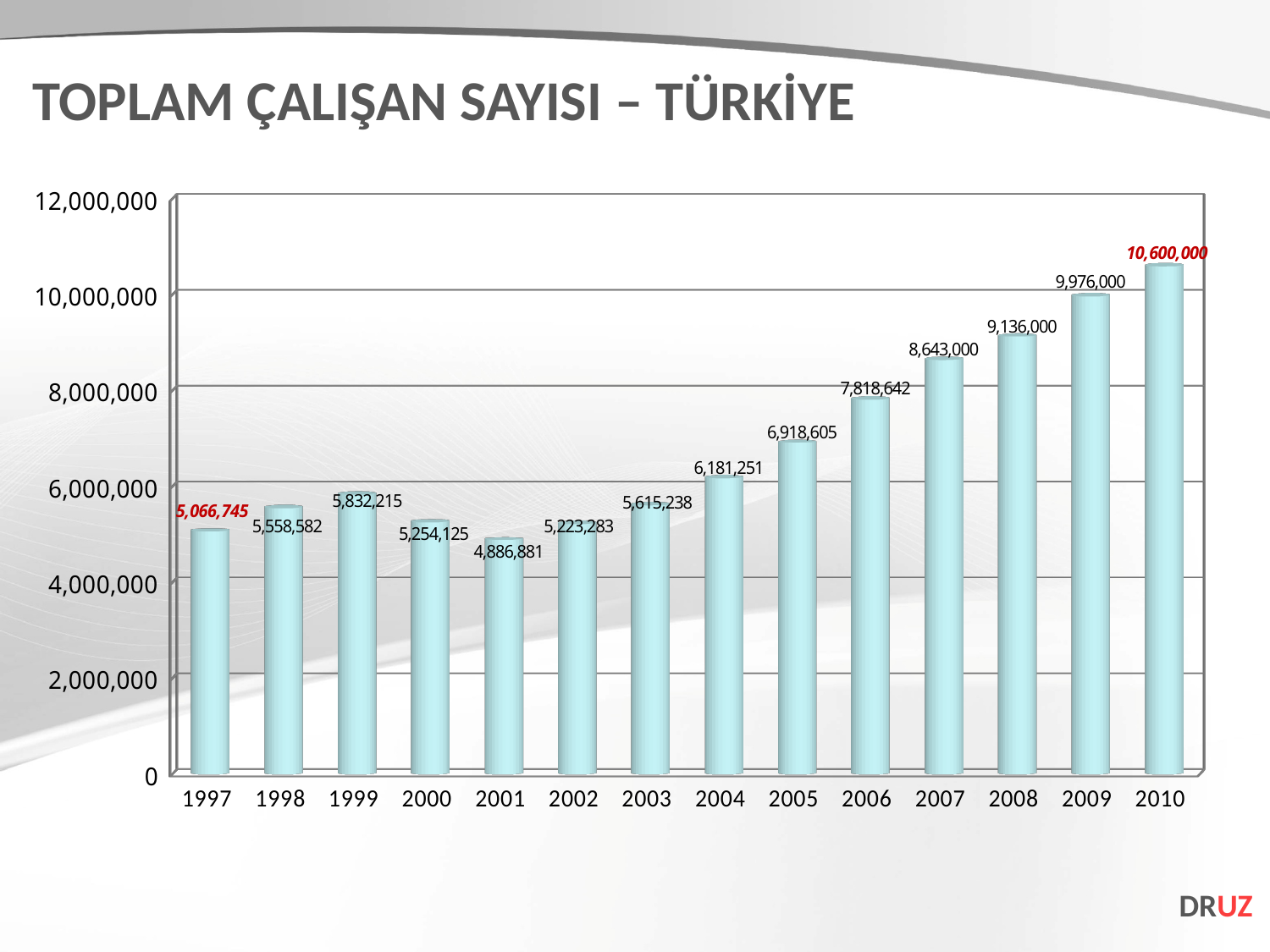
Which year has the highest value? 2010 What kind of chart is shown on the slide? Bar chart How many years are shown on the x axis? 14 What is the value for 2001? 4,886,881 What is the title of the chart? TOPLAM ÇALIŞAN SAYISI – TÜRKİYE What is the difference between the values for 2010 and 1997? 5,533,255 What is the value for 2006? 7,818,642 What is the value for 1997? 5,066,745 Which year has the lowest value? 2001 Which is larger, the value for 1999 or the value for 2003? 1999 What is the value for 2010? 10,600,000 What is the difference between the values for 2009 and 2008? 840,000